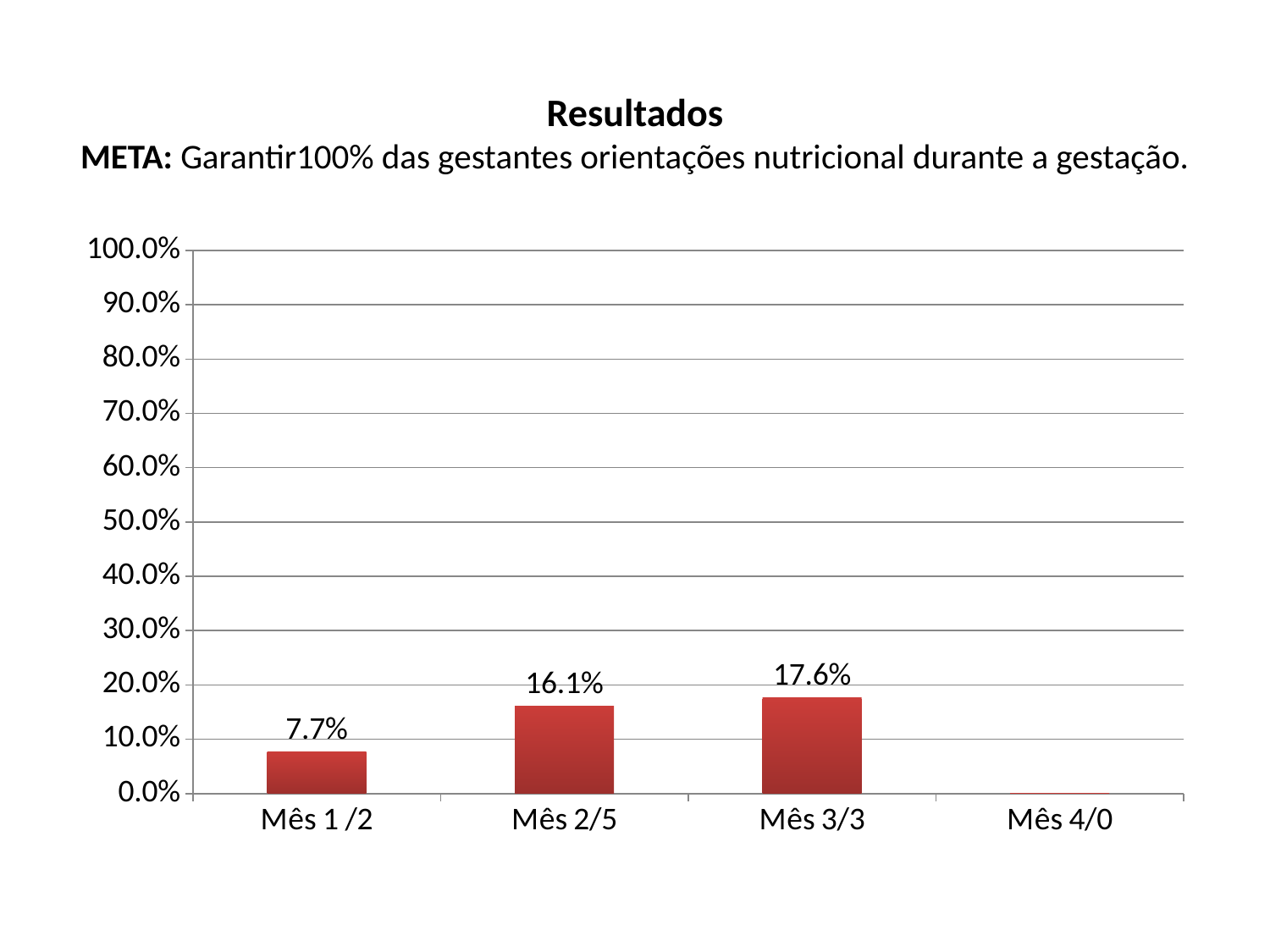
Which is larger, the value for Mês 2/5 or the value for Mês 1 /2? Mês 2/5 What is the difference between the values for Mês 3/3 and Mês 2/5? 1.5% What is the value for Mês 2/5? 16.1% Which category has the highest value? Mês 3/3 How many categories are shown on the x axis? 4 Is the value for Mês 1 /2 greater or less than 10.0%? less Do the values rise or fall from Mês 1 /2 to Mês 3/3? Rise What kind of chart is shown on the slide? Bar chart Is the value for Mês 3/3 greater or less than 20.0%? less What is the value for Mês 3/3? 17.6% What is the difference between the values for Mês 2/5 and Mês 1 /2? 8.4% What is the value for Mês 1 /2? 7.7%